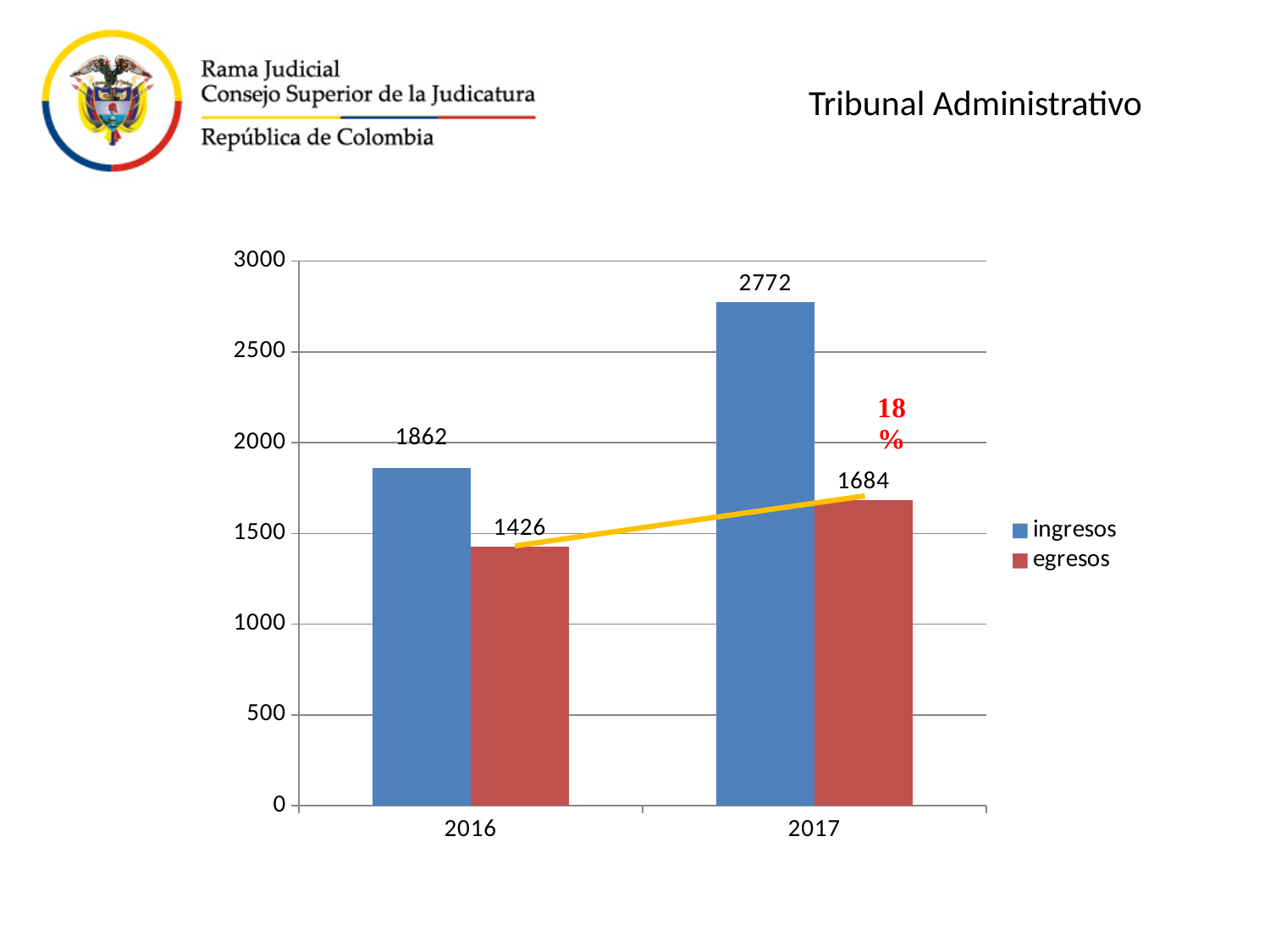
Which year has the lowest egresos value? 2016 What kind of chart is shown on the slide? bar chart What is the value of egresos for 2017? 1684 What is the value of ingresos for 2017? 2772 What is the difference between egresos in 2017 and egresos in 2016? 258 Which year has the highest ingresos value? 2017 What is the difference between ingresos and egresos in 2017? 1088 What is the value of ingresos for 2016? 1862 How many series does the legend list? 2 Which is larger in 2016, ingresos or egresos? ingresos Do the egresos values rise or fall from 2016 to 2017? rise What is the value of egresos for 2016? 1426